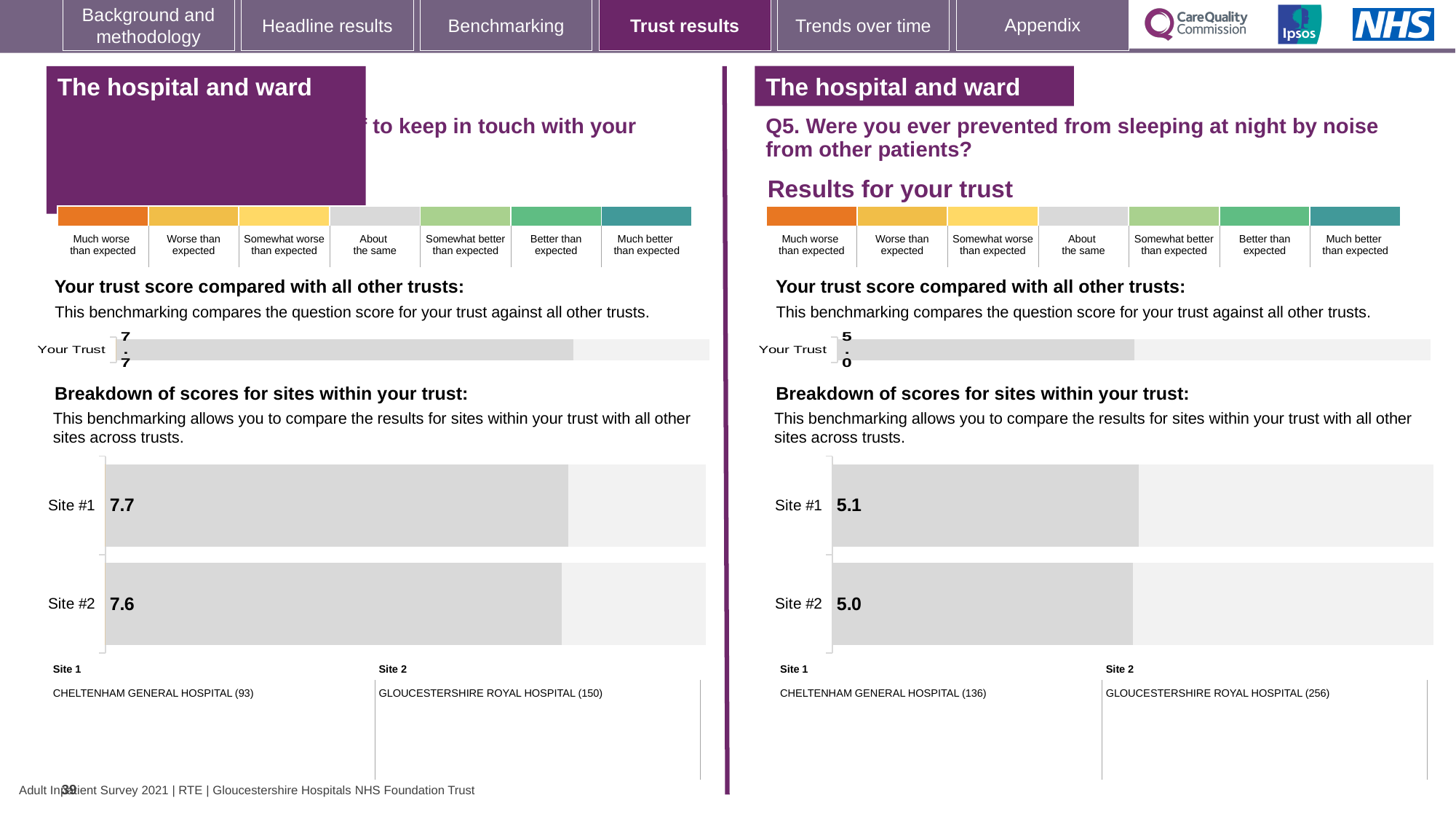
On the right-hand chart (Q5), what is the score shown for Your Trust? 5.0 On the right-hand chart (Q5), what is the difference between the Site #1 score and the Site #2 score? 0.1 On the right-hand chart (Q5), which site has the higher score, Site #1 or Site #2? Site #1 What type of chart is used to show the breakdown of scores for sites on the right-hand side (Q5)? Bar chart How many sites are shown in the site breakdown chart on the right-hand side (Q5)? 2 On the right-hand side (Q5), which hospital is listed as Site 2? GLOUCESTERSHIRE ROYAL HOSPITAL (256) On the left-hand chart, what is the score for Site #2? 7.6 On the left-hand chart, what is the score for Site #1? 7.7 On the right-hand chart (Q5, prevented from sleeping at night by noise from other patients), what is the score for Site #1? 5.1 On the left-hand chart, what is the difference between the Site #1 score and the Site #2 score? 0.1 On the right-hand chart (Q5), what is the score for Site #2? 5.0 On the left-hand chart, what is the score shown for Your Trust? 7.7